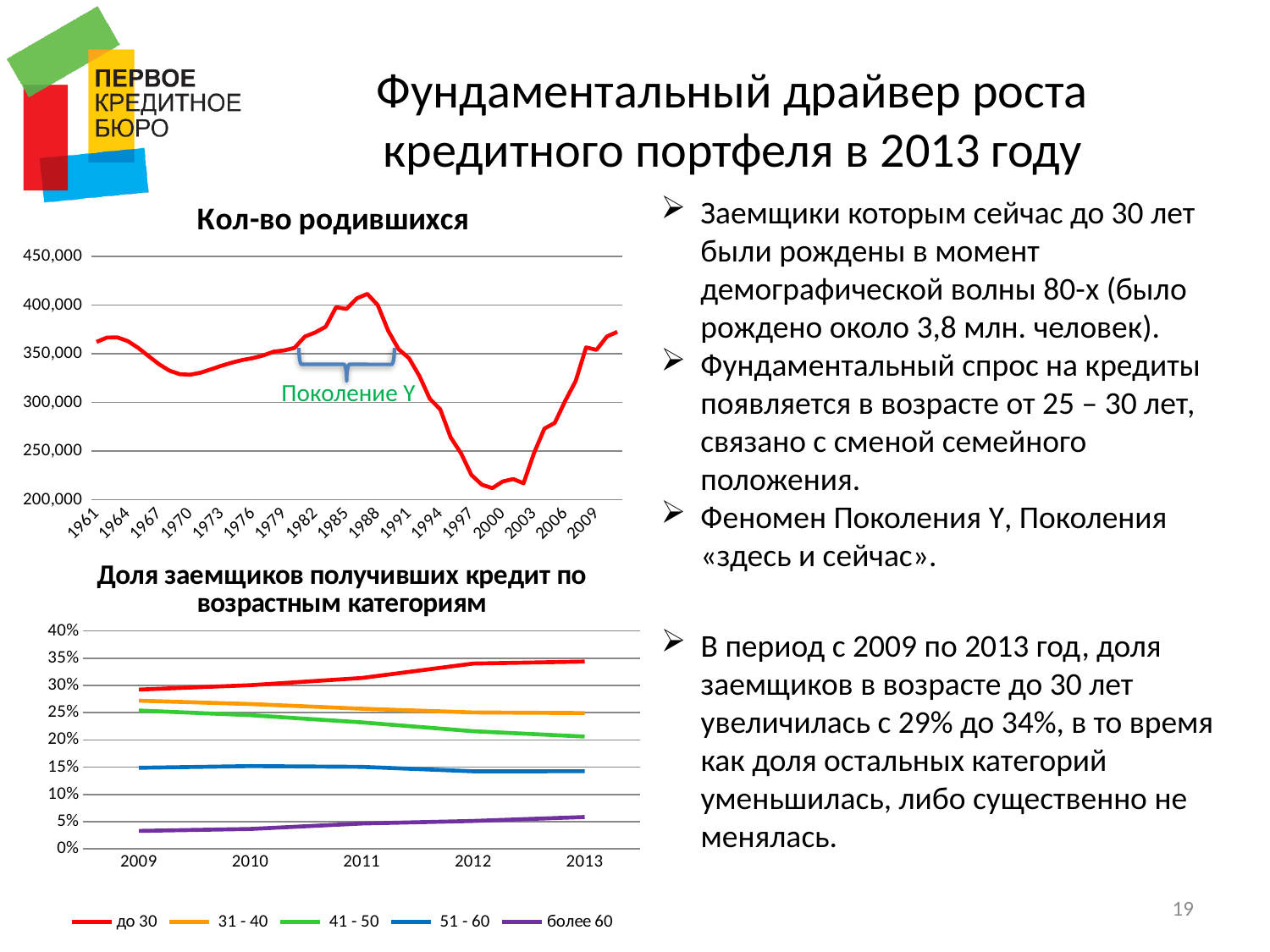
What kind of chart is the 'Кол-во родившихся' chart? line chart In the 'Кол-во родившихся' chart, which generation is labelled with a bracket on the line? Поколение Y In the 'Доля заемщиков получивших кредит по возрастным категориям' chart, does the share for 'до 30' rise or fall from 2009 to 2013? rise In the 'Кол-во родившихся' chart, is the value for 2000 greater or less than 250,000? less How many series does the legend of the 'Доля заемщиков получивших кредит по возрастным категориям' chart list? 5 In the 'Доля заемщиков получивших кредит по возрастным категориям' chart, which age category has the lowest share in 2009? более 60 How many years are shown on the x axis of the 'Доля заемщиков получивших кредит по возрастным категориям' chart? 5 In the 'Доля заемщиков получивших кредит по возрастным категориям' chart, is the value for '41 - 50' in 2013 greater or less than 25%? less In the 'Доля заемщиков получивших кредит по возрастным категориям' chart, which age category has the highest share in 2013? до 30 In the 'Доля заемщиков получивших кредит по возрастным категориям' chart, which is larger in 2013: '31 - 40' or '51 - 60'? 31 - 40 In the 'Кол-во родившихся' chart, is the value for 1970 greater or less than 350,000? less